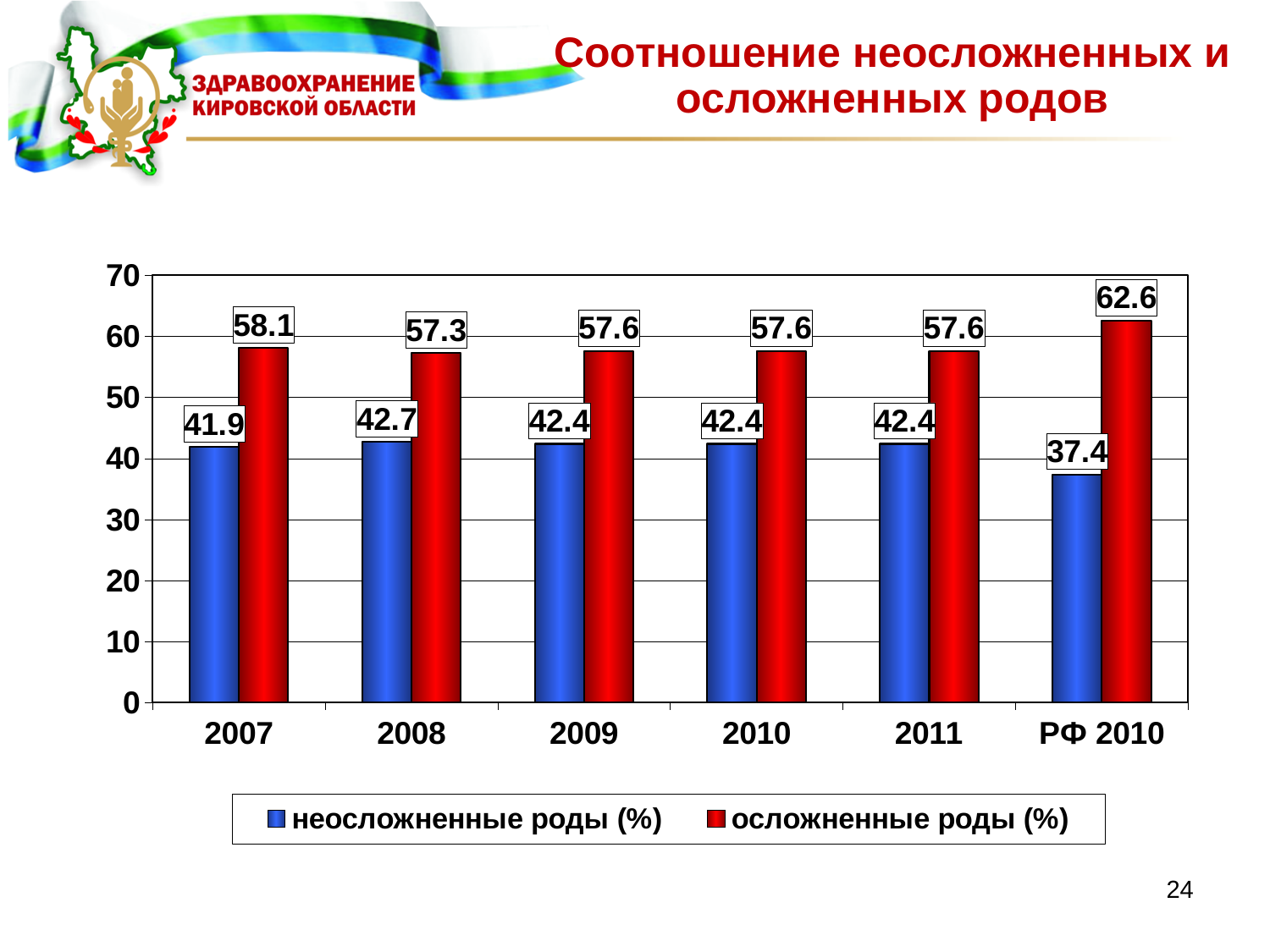
What is the value of осложненные роды (%) for 2008? 57.3 What is the difference between осложненные роды (%) and неосложненные роды (%) for 2011? 15.2 Which is larger for 2008: неосложненные роды (%) or осложненные роды (%)? осложненные роды (%) What kind of chart is shown on the slide? bar chart What is the value of неосложненные роды (%) for 2007? 41.9 How many categories are shown on the x axis? 6 What is the value of осложненные роды (%) for РФ 2010? 62.6 What colour are the bars for осложненные роды (%)? red What is the total of неосложненные роды (%) and осложненные роды (%) for 2007? 100 How many series does the legend list? 2 Which category has the highest value for осложненные роды (%)? РФ 2010 Which category has the lowest value for неосложненные роды (%)? РФ 2010